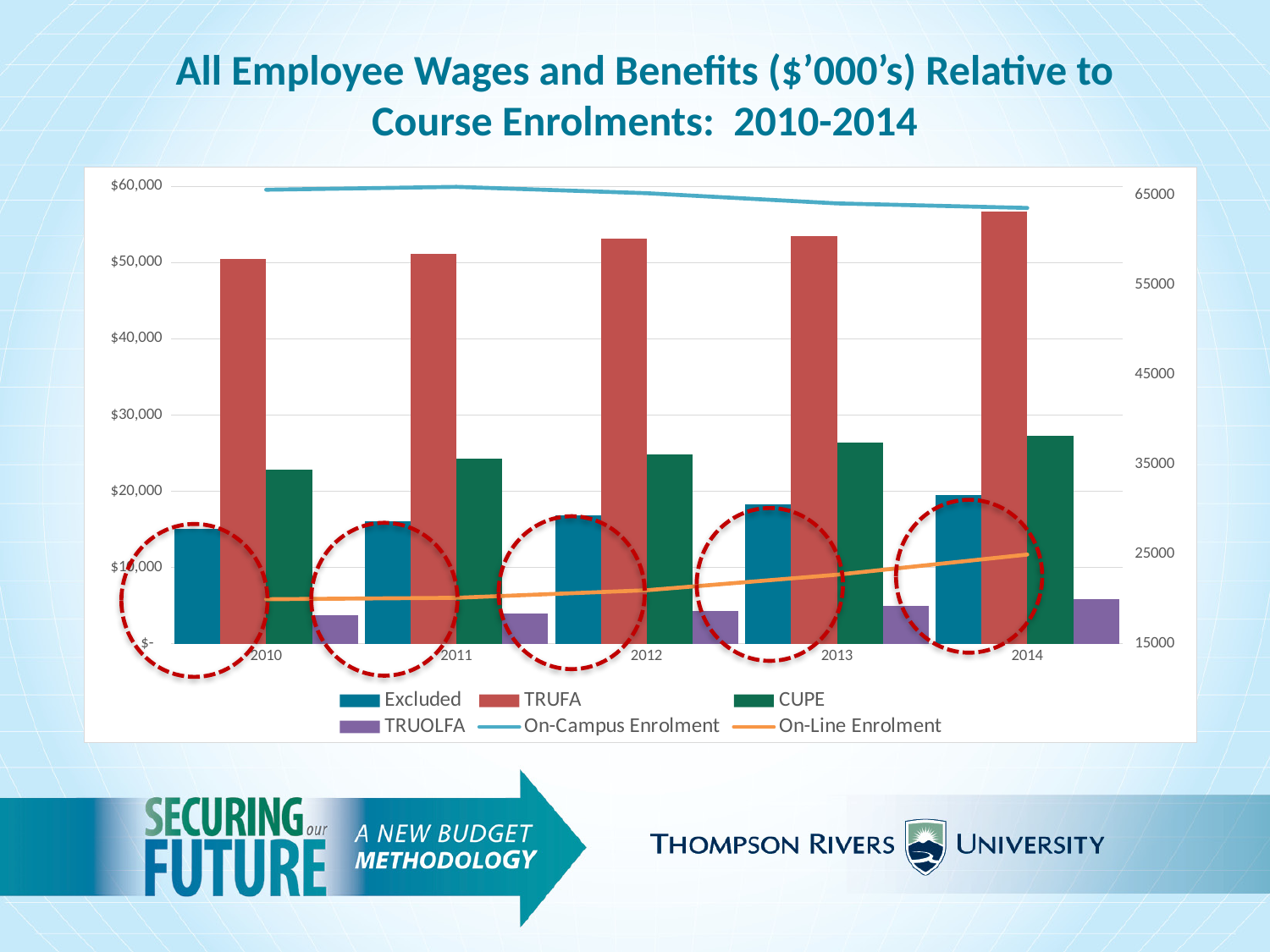
Which employee group has the shortest bars in every year? TRUOLFA How many years are shown on the x axis of the chart? 5 Does the On-Campus Enrolment line rise or fall from 2011 to 2014? Falls Does the On-Line Enrolment line rise or fall from 2010 to 2014? Rises Which employee group has the tallest bars in every year? TRUFA Is the Excluded value for 2010 greater or less than $20,000? less In 2012, which is larger: the TRUFA bar or the CUPE bar? TRUFA In which year is the TRUFA bar the highest? 2014 Is the CUPE value for 2010 greater or less than $30,000? less Is the TRUFA value for 2014 greater or less than $50,000? greater What kind of chart is shown on the slide? A combined bar and line chart How many series does the chart's legend list? 6